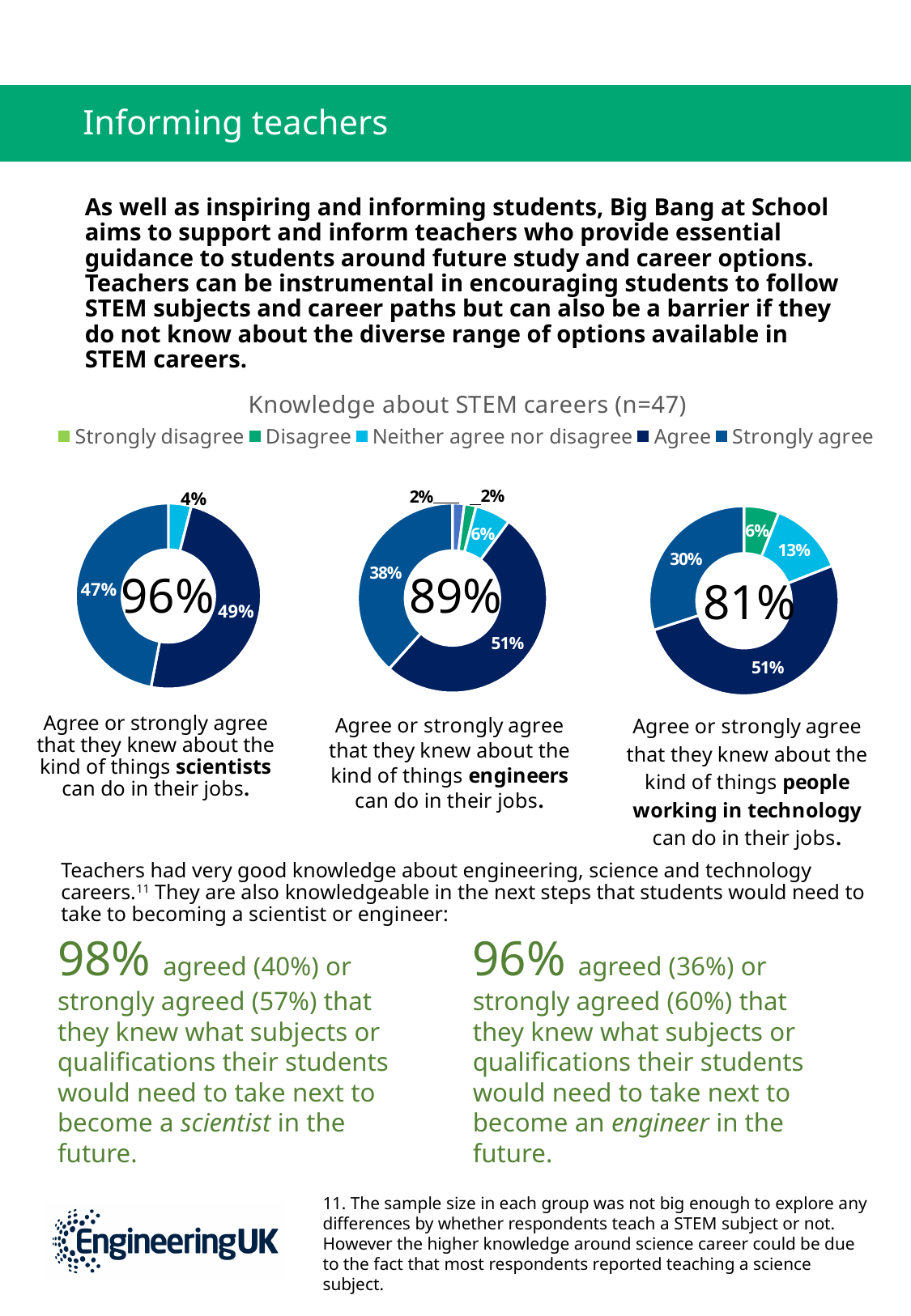
How many slices does the right doughnut chart (people working in technology) have? 4 Which is larger in the left doughnut chart (scientists): the 'Agree' share or the 'Strongly agree' share? Agree How many series does the legend list for the doughnut charts? 5 In the middle doughnut chart (engineers), what percentage answered 'Strongly agree'? 38% In the right doughnut chart (people working in technology), what percentage answered 'Neither agree nor disagree'? 13% In the left doughnut chart (scientists), what percentage answered 'Neither agree nor disagree'? 4% What is the title of the chart group on the slide? Knowledge about STEM careers (n=47) In the middle doughnut chart (engineers), which response category has the largest share? Agree In the right doughnut chart (people working in technology), what is the difference between the 'Agree' and 'Strongly agree' shares? 21% In the left doughnut chart (scientists), what percentage of teachers answered 'Agree'? 49% What is the combined agree or strongly agree figure shown in the centre of the middle doughnut chart (engineers)? 89% What kind of chart is used to show knowledge about STEM careers? Doughnut chart